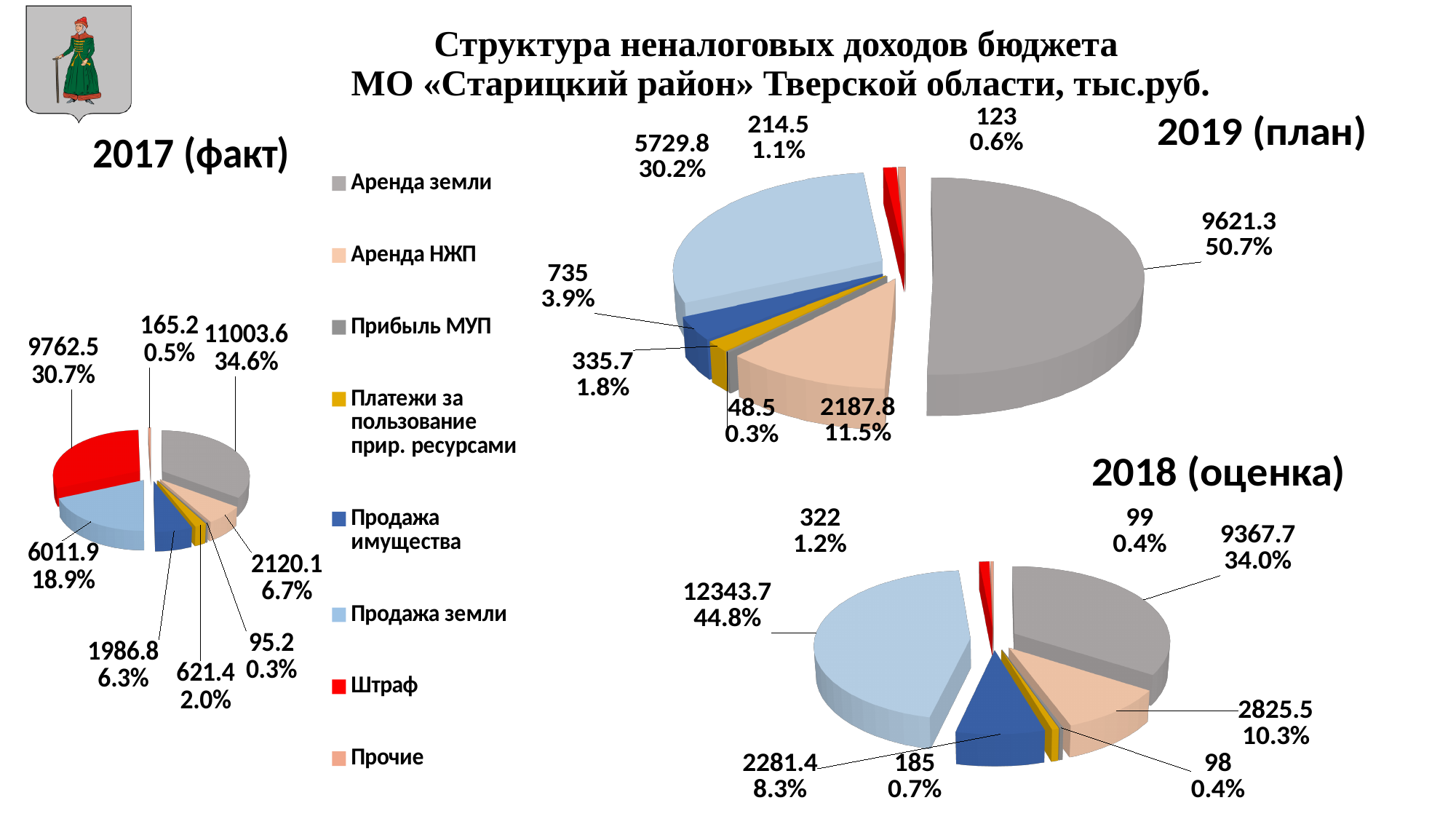
In the 2017 (факт) chart, what is the value for Аренда земли? 11003.6 In the 2018 (оценка) chart, what is the difference between Продажа земли (12343.7) and Аренда земли (9367.7)? 2976 In the 2019 (план) chart, what is the value for Продажа земли? 5729.8 In the 2018 (оценка) chart, what is the value for Аренда НЖП? 2825.5 How many series does the legend list? 8 In the 2018 (оценка) chart, which is larger: Продажа имущества or Аренда НЖП? Аренда НЖП In the 2019 (план) chart, which category has the smallest value? Прибыль МУП In the 2017 (факт) chart, what share of the pie is Штраф? 30.7% In the 2018 (оценка) chart, what share of the pie is Продажа земли? 44.8% What kind of charts are shown on the slide? Pie charts In the 2019 (план) chart, which category has the largest share? Аренда земли Which colour represents Штраф in the legend? Red